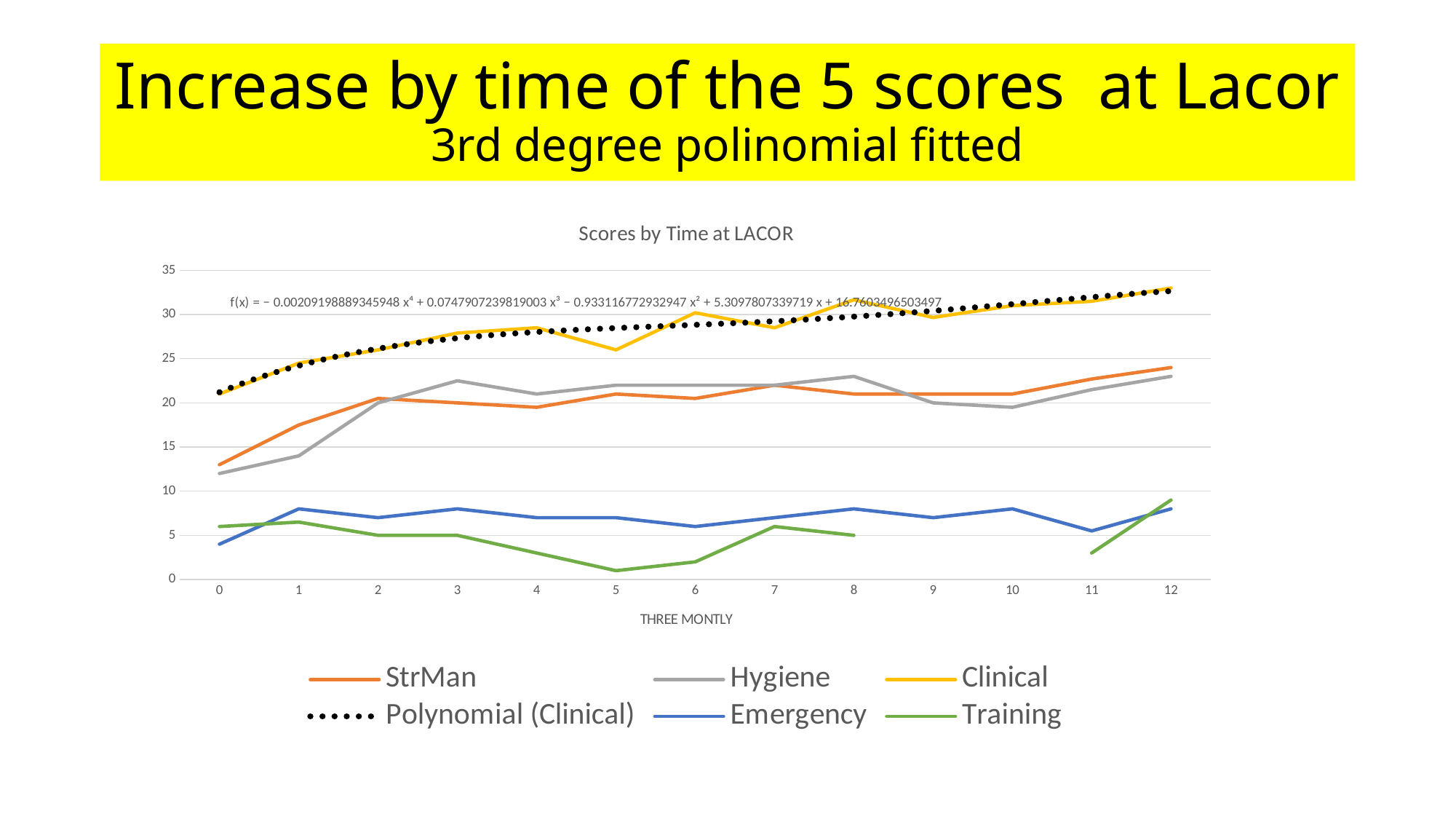
What is the title of the chart? Scores by Time at LACOR Is the value for Clinical at x = 0 greater or less than 20? greater What kind of chart is shown on the slide? line chart Is the value for Training at x = 5 greater or less than 5? less Which series is drawn as a dotted line? Polynomial (Clinical) How many series does the legend list? 6 Does the Clinical series generally rise or fall from x = 0 to x = 12? rise Which series has the highest value at x = 12? Clinical Is the value for Emergency at x = 0 greater or less than 5? less Which series has the lowest value at x = 5? Training How many points are marked along the x axis (THREE MONTLY)? 13 At x = 3, which is larger: Hygiene or StrMan? Hygiene